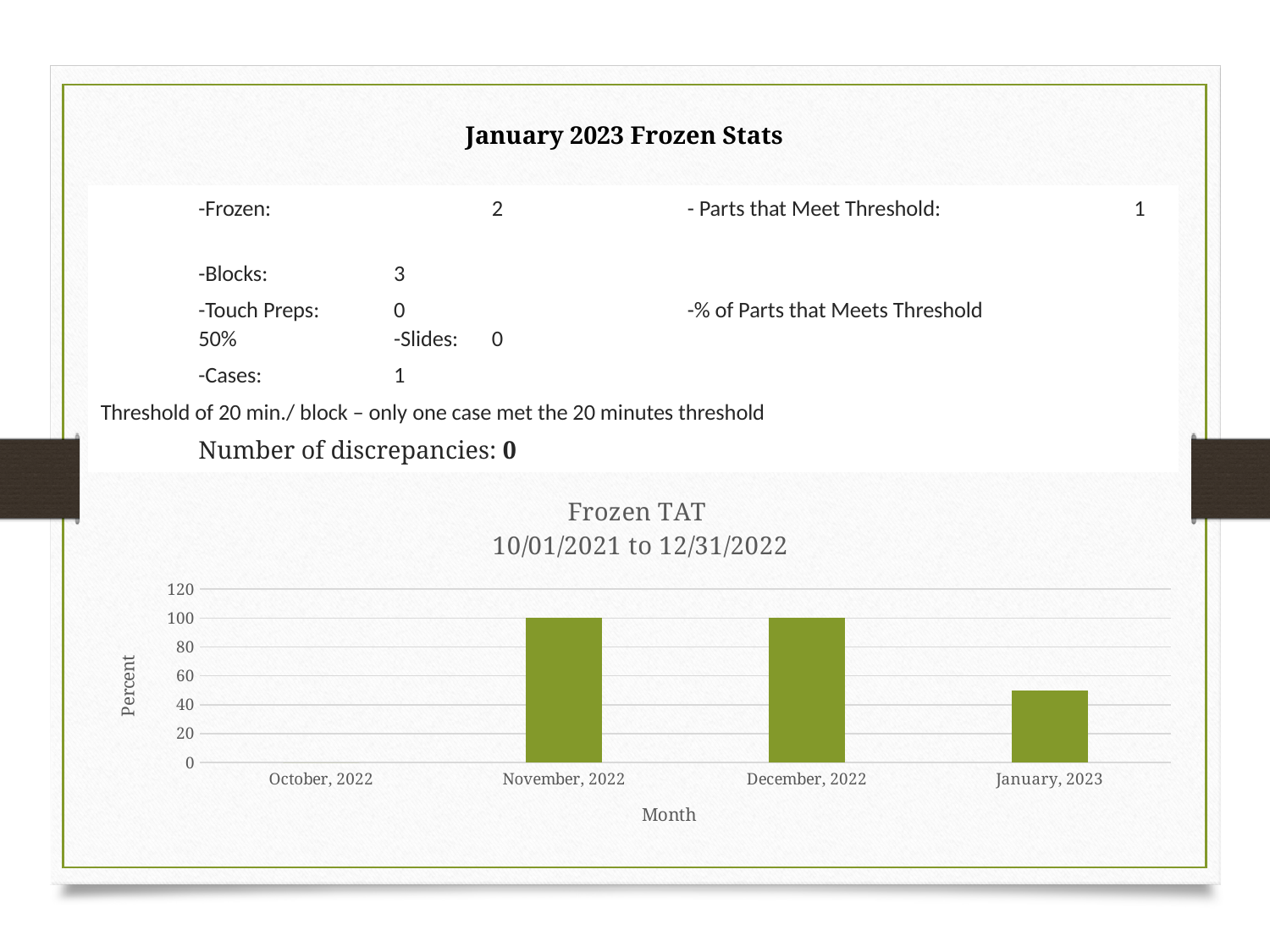
What is the difference between the values for November, 2022 and October, 2022? 100 What kind of chart is shown on the slide? bar chart What is the label on the y axis of the chart? Percent What is the value for November, 2022 in the Frozen TAT chart? 100 Which is larger, the value for December, 2022 or the value for January, 2023? December, 2022 What is the value for October, 2022 in the Frozen TAT chart? 0 Which month has the lowest value in the Frozen TAT chart? October, 2022 Is the value for January, 2023 greater or less than 80? less What is the title of the chart? Frozen TAT 10/01/2021 to 12/31/2022 Is the value for January, 2023 greater or less than 20? greater What is the value for December, 2022 in the Frozen TAT chart? 100 How many months are shown on the x axis of the chart? 4